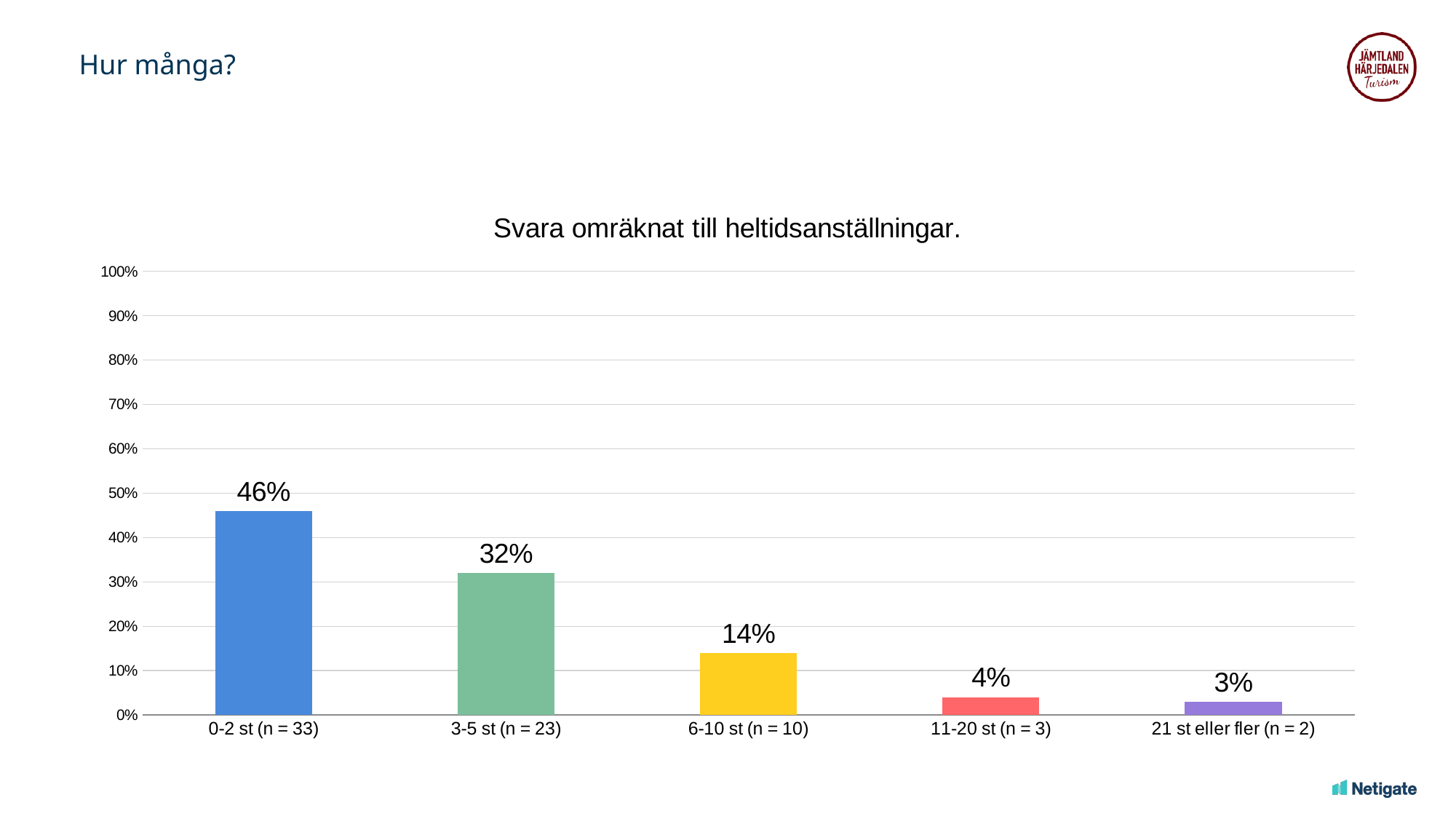
What is the value for the category "3-5 st (n = 23)"? 32% What is the value for the category "6-10 st (n = 10)"? 14% Which is larger, the value for "6-10 st (n = 10)" or the value for "11-20 st (n = 3)"? 6-10 st (n = 10) How many categories are shown on the x axis? 5 What is the value for the category "0-2 st (n = 33)"? 46% Which category has the lowest value? 21 st eller fler (n = 2) What kind of chart is shown on the slide? bar chart Is the value for "0-2 st (n = 33)" greater or less than 50%? less Which category has the highest value? 0-2 st (n = 33) What is the title of the chart? Svara omräknat till heltidsanställningar. What is the difference between the values for "0-2 st (n = 33)" and "3-5 st (n = 23)"? 14% What is the value for the category "21 st eller fler (n = 2)"? 3%